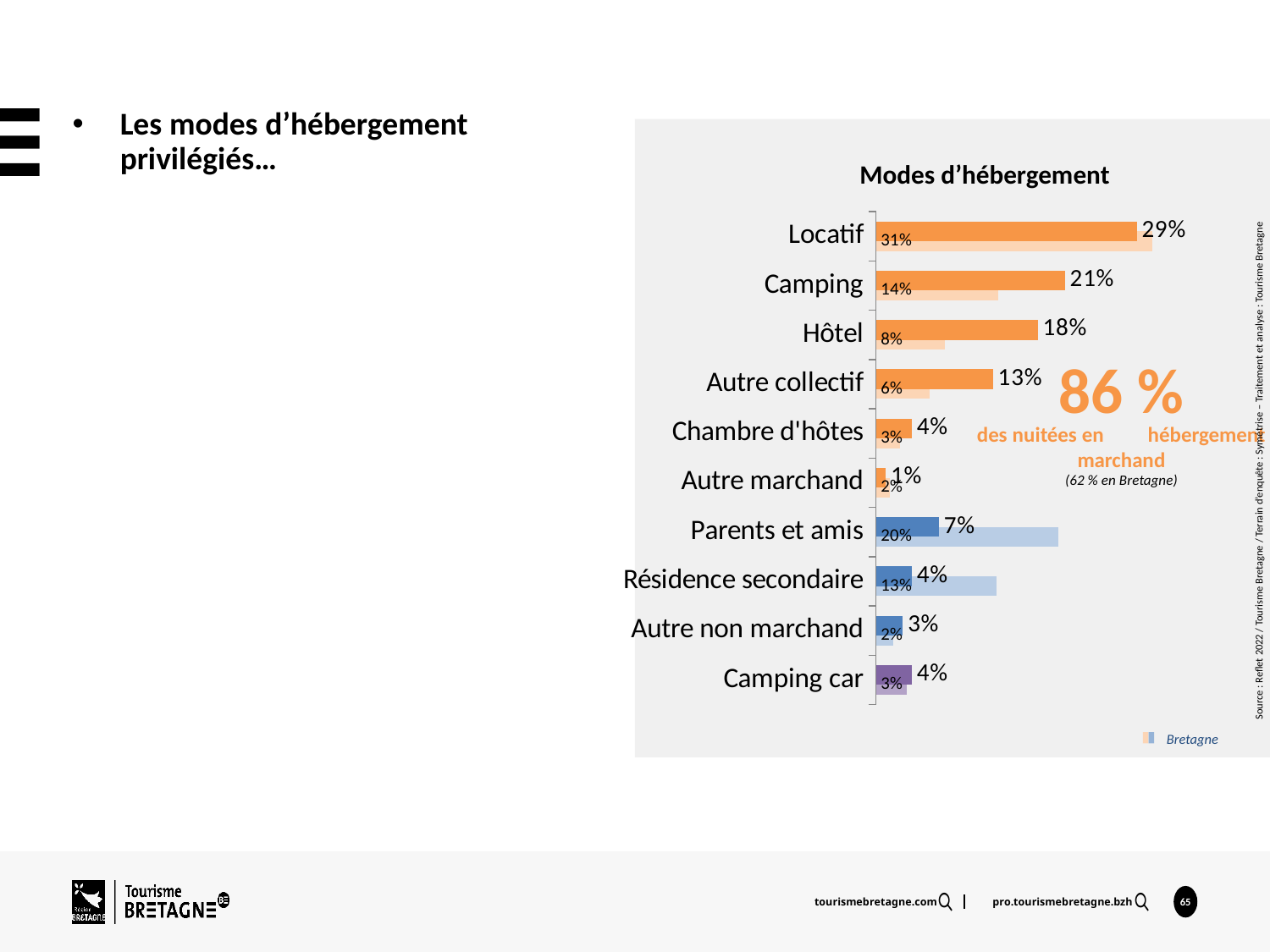
What is the value of the darker bar for Hôtel? 18% What large highlighted percentage is shown inside the chart area for nights in commercial accommodation (hébergement marchand)? 86 % Which category has the lowest value in the darker series? Autre marchand How many accommodation categories are listed in the Modes d'hébergement chart? 10 What is the value shown for Locatif (the darker bar) in the Modes d'hébergement chart? 29% What is the Bretagne value for Camping in the Modes d'hébergement chart? 14% For Parents et amis, is the Bretagne value larger or smaller than the darker-bar value? larger What is the Bretagne value for Parents et amis? 20% What is the Bretagne value for Résidence secondaire? 13% Which category has the highest value in the darker series? Locatif What type of chart is used for Modes d'hébergement? bar chart What is the difference between the darker-bar values for Locatif (29%) and Camping (21%)? 8 percentage points